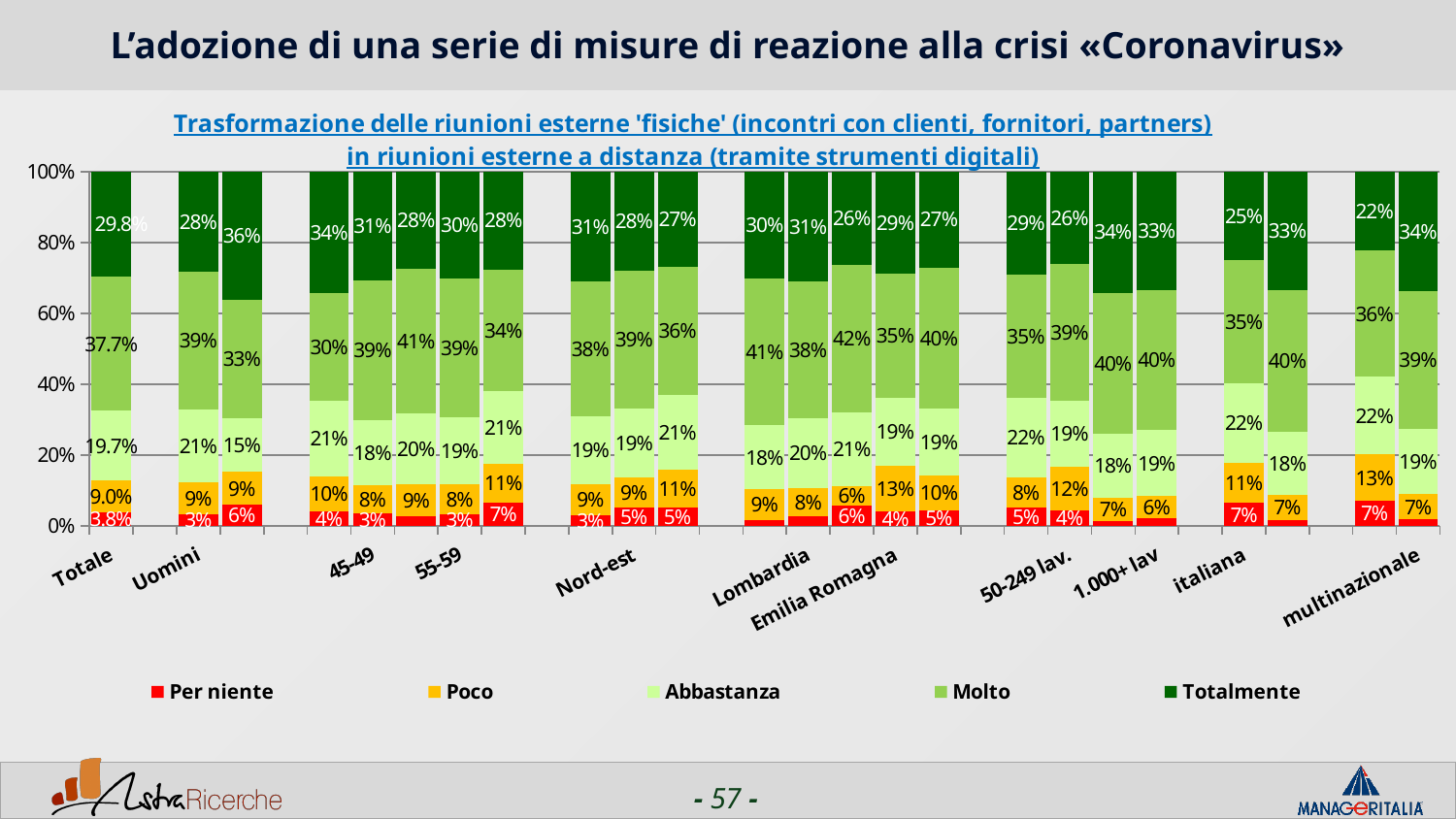
What is the 'Totalmente' value for the 'Totale' bar? 29.8% Which series is listed first in the legend? Per niente How many series does the legend list? 5 In the 'Totale' bar, which is larger: the 'Molto' segment or the 'Totalmente' segment? Molto What is the 'Per niente' value for the 'Totale' bar? 3.8% What kind of chart is shown on the slide? Stacked bar chart What is the 'Molto' value for 'Uomini'? 39% What is the 'Molto' value for the 'Totale' bar? 37.7% In the 'Totale' bar, what is the difference between the 'Molto' value and the 'Abbastanza' value? 18.0 percentage points What is the 'Poco' value for 'Emilia Romagna'? 13% Is the 'Totalmente' value for 'Totale' greater or less than 20%? greater What is the 'Totalmente' value for 'Uomini'? 28%